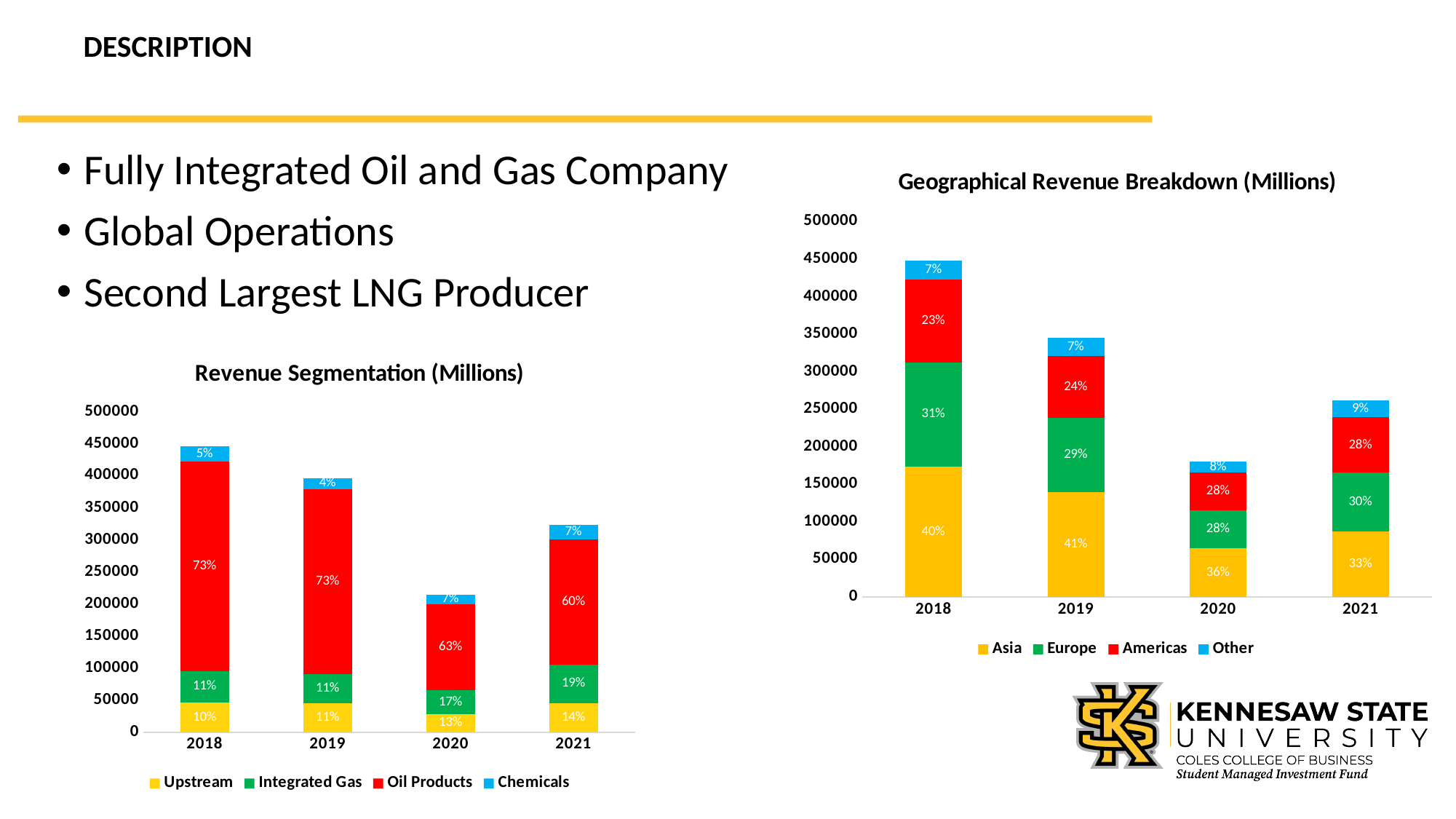
In the 'Geographical Revenue Breakdown (Millions)' chart, is the total height of the 2020 bar greater or less than 200000? less In the 'Revenue Segmentation (Millions)' chart, by how many percentage points does the Oil Products share in 2018 exceed its share in 2021? 13 percentage points In the 'Revenue Segmentation (Millions)' chart, what percentage label is shown for Oil Products in 2020? 63% In the 'Geographical Revenue Breakdown (Millions)' chart, which has the larger share in 2018, Europe or Americas? Europe In the 'Revenue Segmentation (Millions)' chart, is the total height of the 2018 bar greater or less than 400000? greater How many series does the legend of the 'Revenue Segmentation (Millions)' chart list? 4 In the 'Geographical Revenue Breakdown (Millions)' chart, what percentage label is shown for Asia in 2019? 41% In the 'Geographical Revenue Breakdown (Millions)' chart, does the Asia percentage share rise or fall from 2019 to 2021? fall How many years are shown on the x axis of the 'Geographical Revenue Breakdown (Millions)' chart? 4 In the 'Revenue Segmentation (Millions)' chart, which year has the tallest total bar? 2018 What kind of chart is the 'Revenue Segmentation (Millions)' chart? Stacked bar chart In the 'Geographical Revenue Breakdown (Millions)' chart, which year has the shortest total bar? 2020